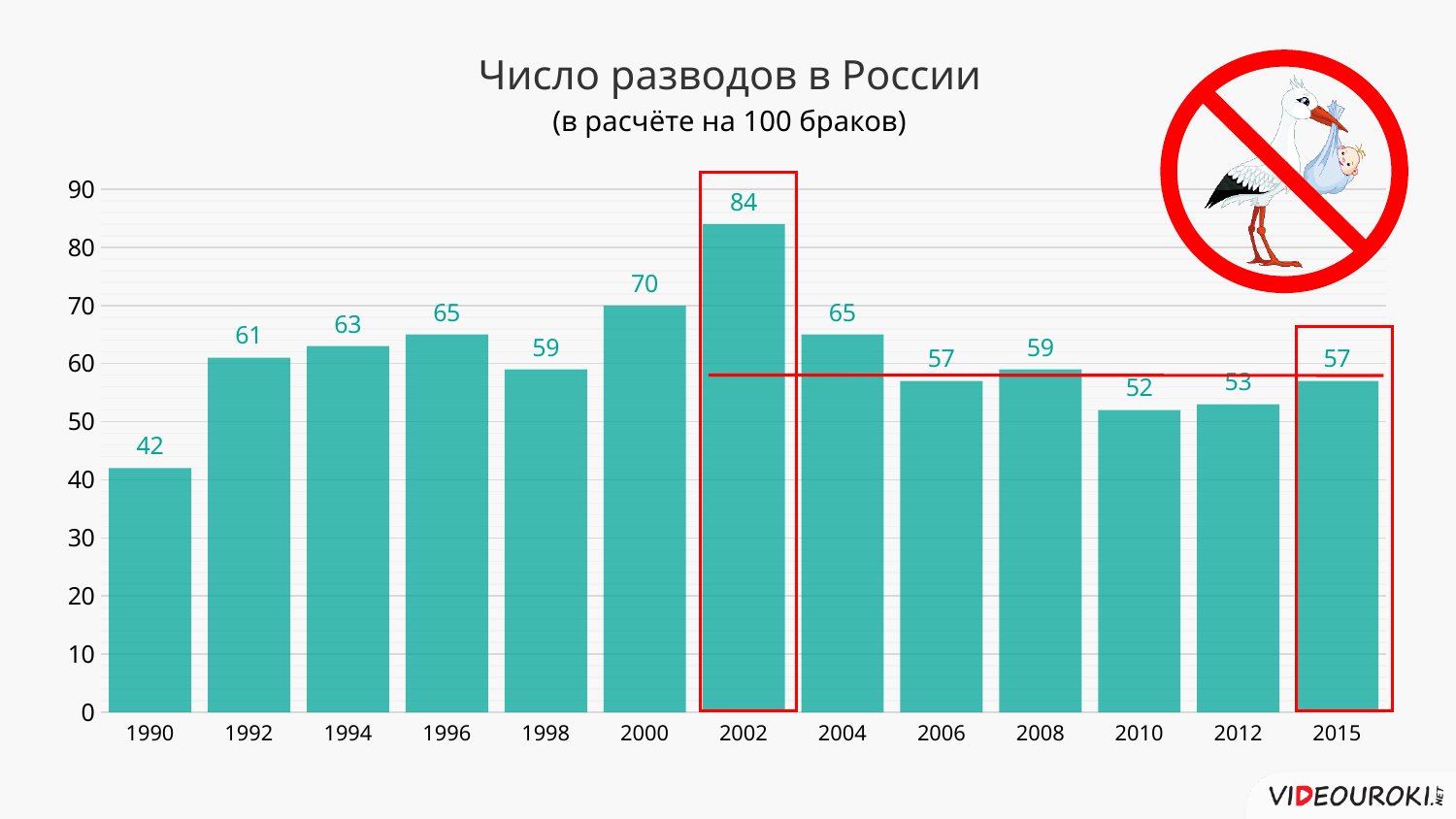
Which year has the lowest value? 1990 What is the value for 1990? 42 What is the title of the chart? Число разводов в России (в расчёте на 100 браков) Is the value for 2012 greater or less than 60? less What kind of chart is shown on the slide? bar chart What is the value for 2002? 84 Do the values rise or fall from 2002 to 2010? fall Which year has the highest value? 2002 How many years are shown on the x axis? 13 What is the value for 2015? 57 Which is larger, the value for 2000 or the value for 2010? 2000 What is the difference between the values for 2002 and 2004? 19